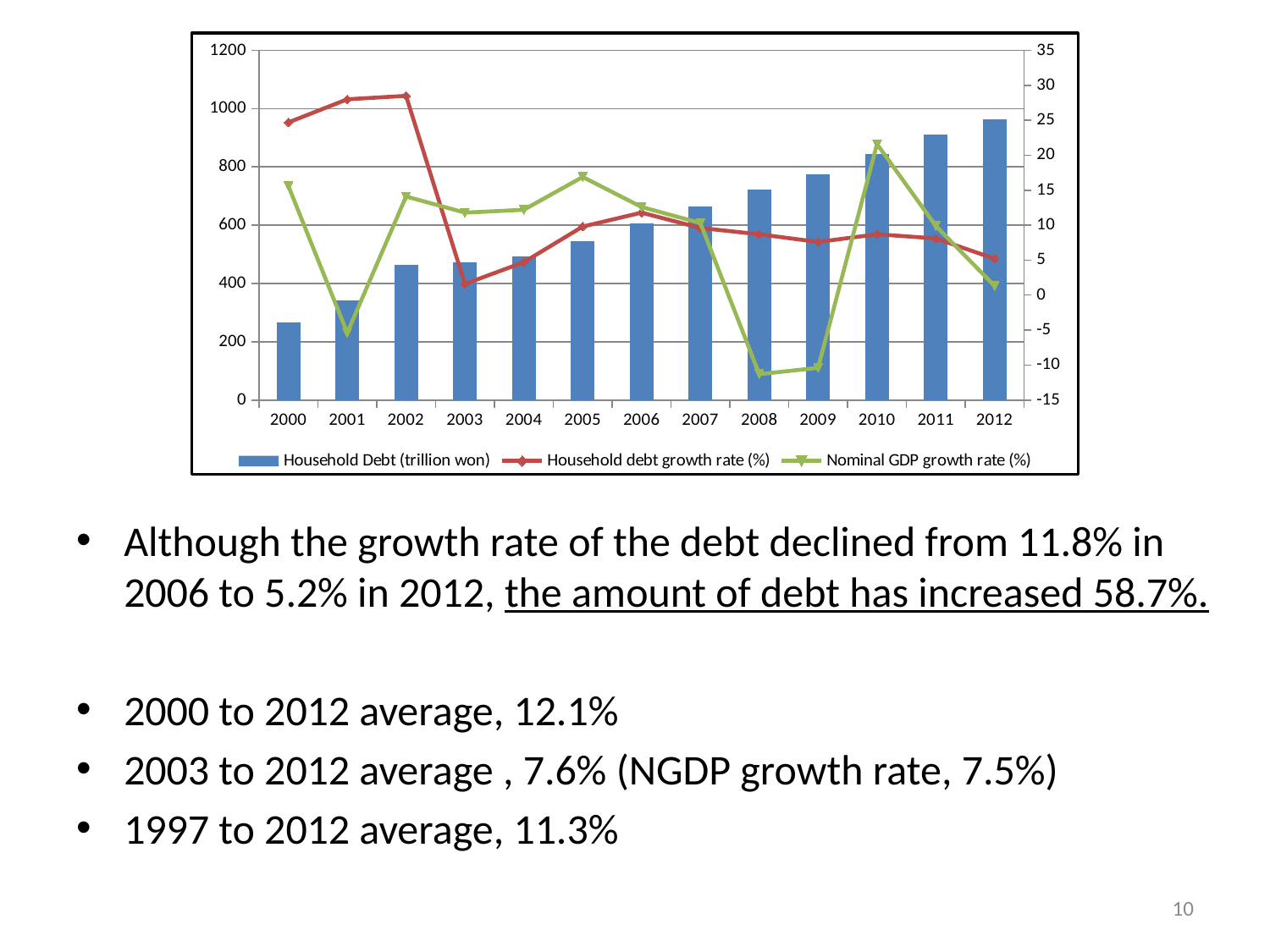
Which year has the highest Nominal GDP growth rate (%)? 2010 Which is larger in 2000, the Household debt growth rate (%) or the Nominal GDP growth rate (%)? Household debt growth rate (%) How many series does the legend list? 3 Does Household Debt (trillion won) rise or fall from 2000 to 2012? Rise Which year has the lowest Household Debt (trillion won)? 2000 How many years are shown on the x axis? 13 What kind of chart is this? Combined bar and line chart Is the Household Debt (trillion won) value for 2000 greater or less than 400? less Is the Household debt growth rate (%) for 2003 greater or less than 5? less Is the Household Debt (trillion won) value for 2012 greater or less than 800? greater Which year has the highest Household Debt (trillion won)? 2012